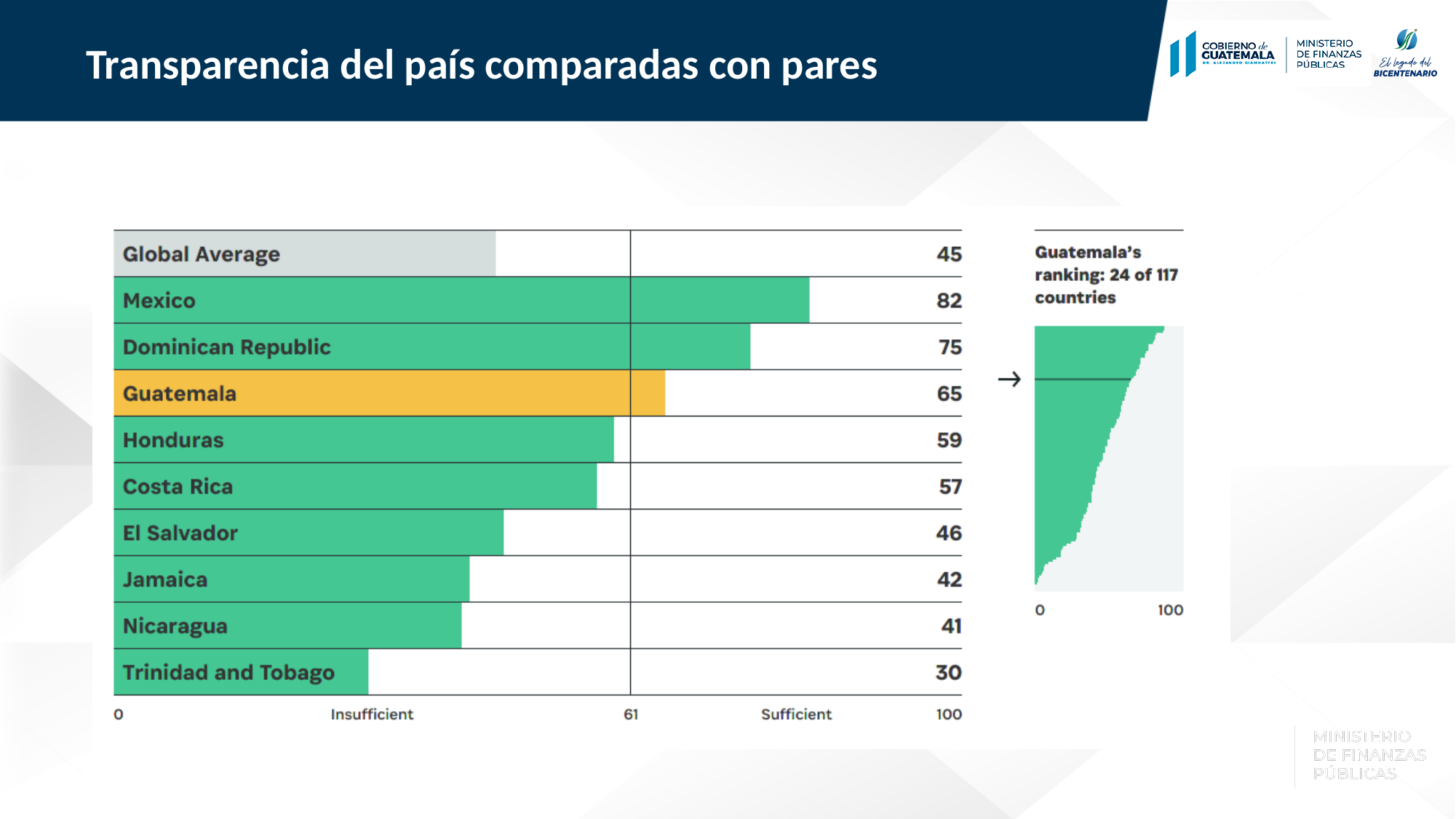
Which country has the highest value? Mexico Which has a larger value, Honduras or Costa Rica? Honduras What is the value for Guatemala? 65 What is the value for the Global Average? 45 What kind of chart is the main chart? bar chart Which country has the lowest value? Trinidad and Tobago What is the difference between the values for Mexico and Guatemala? 17 What is Guatemala's ranking according to the text next to the chart? 24 of 117 countries What is the value for Trinidad and Tobago? 30 Is the value for Dominican Republic greater or less than 61? greater What is the value for Mexico? 82 How many bars are shown in the main chart? 10